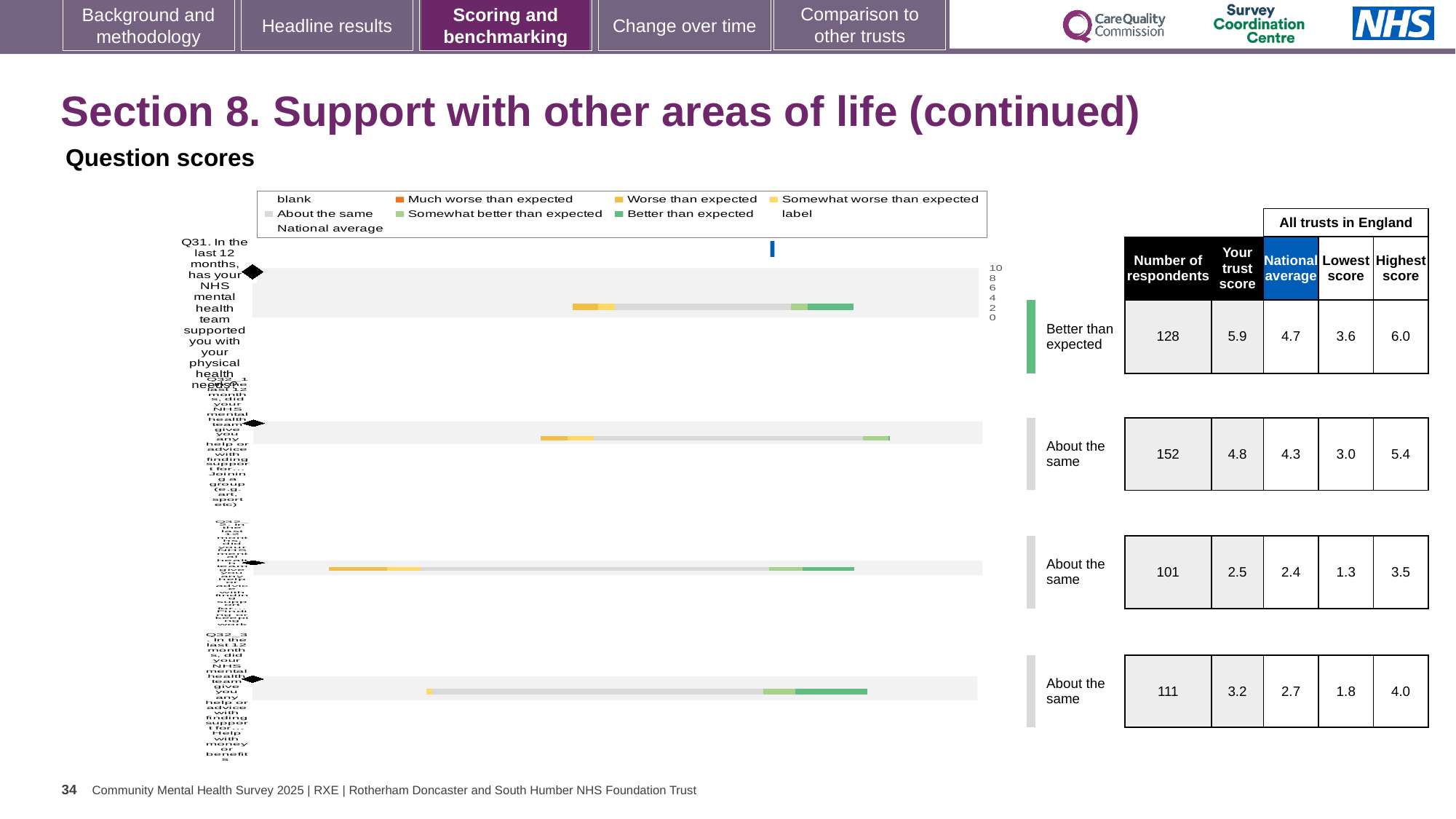
How many entries does the chart legend list? 9 What kind of chart is shown on the slide? bar chart In the table beside the chart, what is the trust score for the top bar (Q31)? 5.9 In the table beside the chart, which bar has the lowest trust score? the third bar (2.5) What is the question number of the first (top) bar in the chart? Q31 What is the highest value shown on the chart's axis? 10 How many of the bars are labelled 'About the same'? 3 In the table beside the chart, what is the national average for the top bar (Q31)? 4.7 Which legend entry is shown in dark green? Better than expected What benchmark label is shown next to the top bar (Q31)? Better than expected How many question bars are plotted in the chart? 4 In the table beside the chart, what is the difference between the trust score and the national average for the bottom bar? 0.5